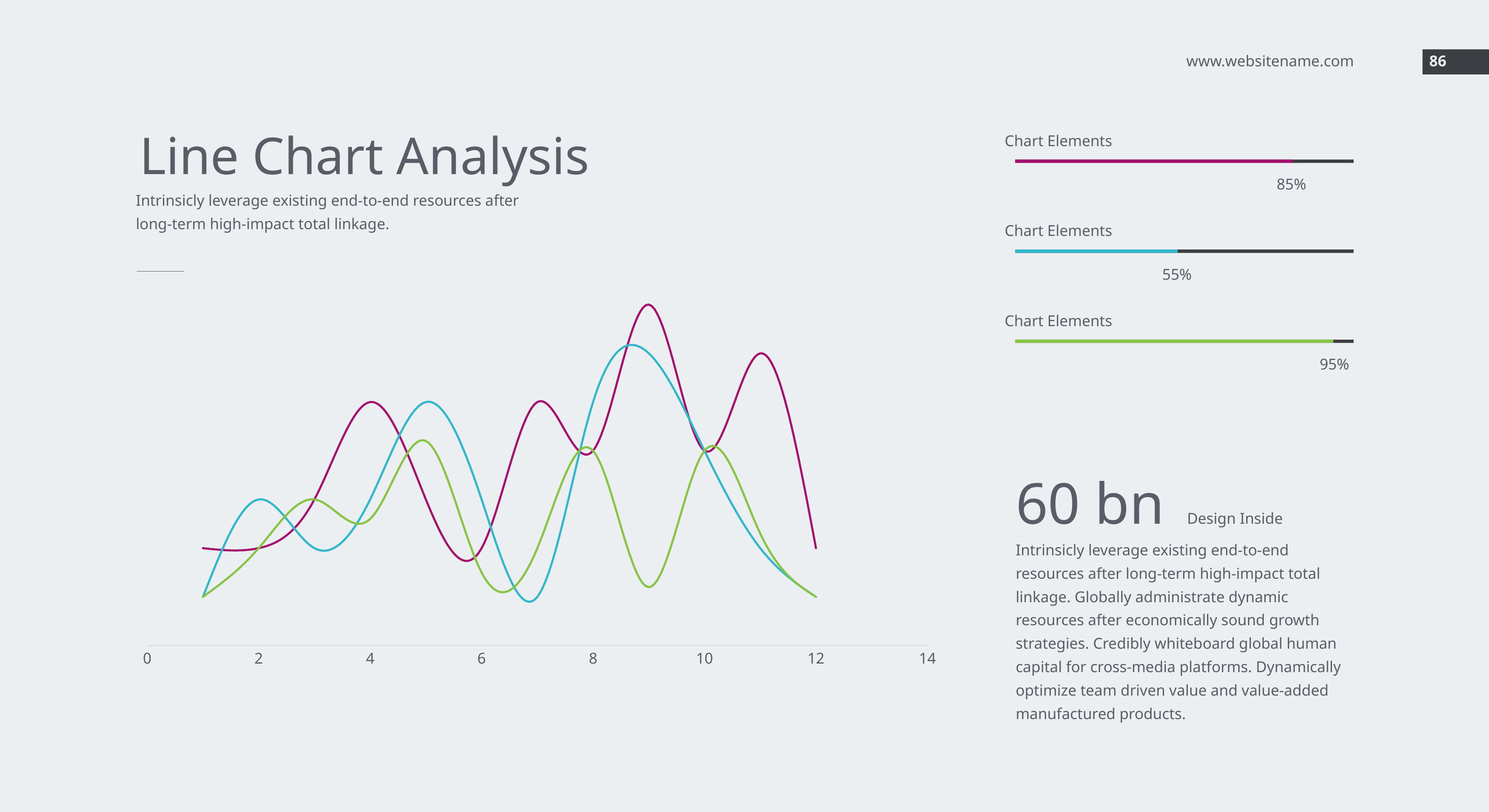
What is the title of the slide containing the line chart? Line Chart Analysis Does the cyan line rise or fall between x = 10 and x = 12? fall How many tick labels are shown on the x axis of the line chart? 8 What kind of chart is shown on the slide? line chart Between which two x-axis tick labels does the magenta line reach its highest peak? 8 and 10 What is the lowest value labelled on the x axis of the line chart? 0 At x = 9, which line is higher: the magenta line or the green line? the magenta line Does the green line rise or fall between x = 1 and x = 3? rise Does the line chart display a legend? No What is the highest value labelled on the x axis of the line chart? 14 How many lines are plotted on the line chart? 3 Which coloured line reaches the highest point on the line chart? the magenta line